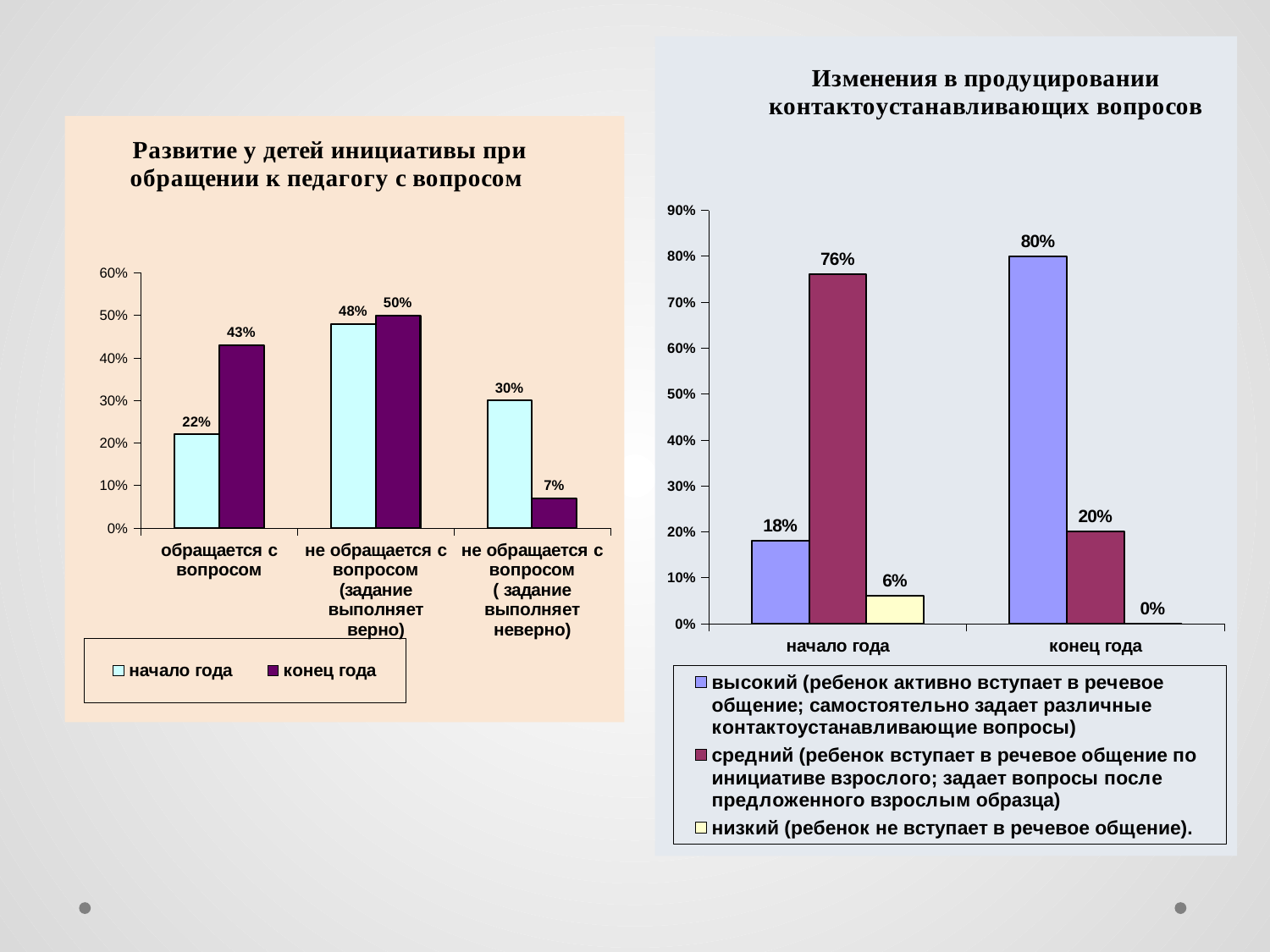
In the right chart 'Изменения в продуцировании контактоустанавливающих вопросов', what is the value for 'низкий' at 'конец года'? 0% In the left chart 'Развитие у детей инициативы при обращении к педагогу с вопросом', which category has the lowest 'конец года' value? не обращается с вопросом (задание выполняет неверно) In the right chart 'Изменения в продуцировании контактоустанавливающих вопросов', what is the value for 'средний' at 'начало года'? 76% In the left chart 'Развитие у детей инициативы при обращении к педагогу с вопросом', how many series does the legend list? 2 In the right chart 'Изменения в продуцировании контактоустанавливающих вопросов', how many series does the legend list? 3 In the left chart 'Развитие у детей инициативы при обращении к педагогу с вопросом', how many categories are shown on the x axis? 3 In the left chart 'Развитие у детей инициативы при обращении к педагогу с вопросом', what is the value for 'не обращается с вопросом (задание выполняет неверно)' at 'начало года'? 30% In the left chart 'Развитие у детей инициативы при обращении к педагогу с вопросом', what is the value for 'обращается с вопросом' at 'конец года'? 43% In the left chart 'Развитие у детей инициативы при обращении к педагогу с вопросом', what is the difference between 'начало года' and 'конец года' for 'обращается с вопросом'? 21% What kind of chart is the right chart 'Изменения в продуцировании контактоустанавливающих вопросов'? bar chart In the right chart 'Изменения в продуцировании контактоустанавливающих вопросов', what is the difference between the 'высокий' values at 'конец года' and 'начало года'? 62% In the right chart 'Изменения в продуцировании контактоустанавливающих вопросов', which is larger at 'начало года': 'высокий' or 'низкий'? высокий